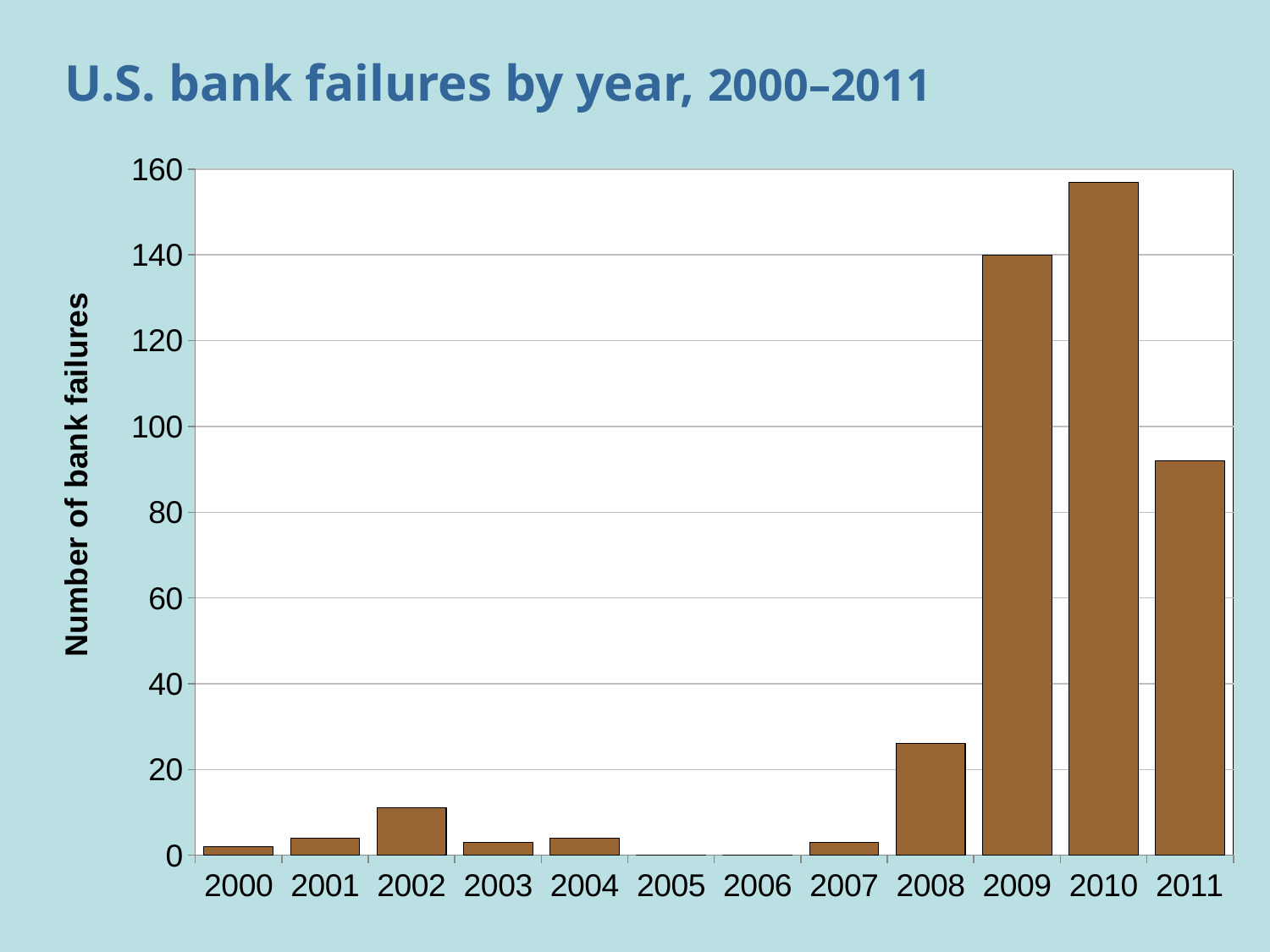
Is the number of bank failures in 2002 greater or less than 20? less What is the label on the y axis? Number of bank failures Do the number of bank failures rise or fall from 2008 to 2010? rise Which year had more bank failures, 2009 or 2011? 2009 Which year had more bank failures, 2008 or 2002? 2008 Is the number of bank failures in 2010 greater or less than 140? greater Is the number of bank failures in 2008 greater or less than 20? greater What type of chart is shown on the slide? bar chart How many years are shown on the x axis? 12 Which year has the highest number of bank failures? 2010